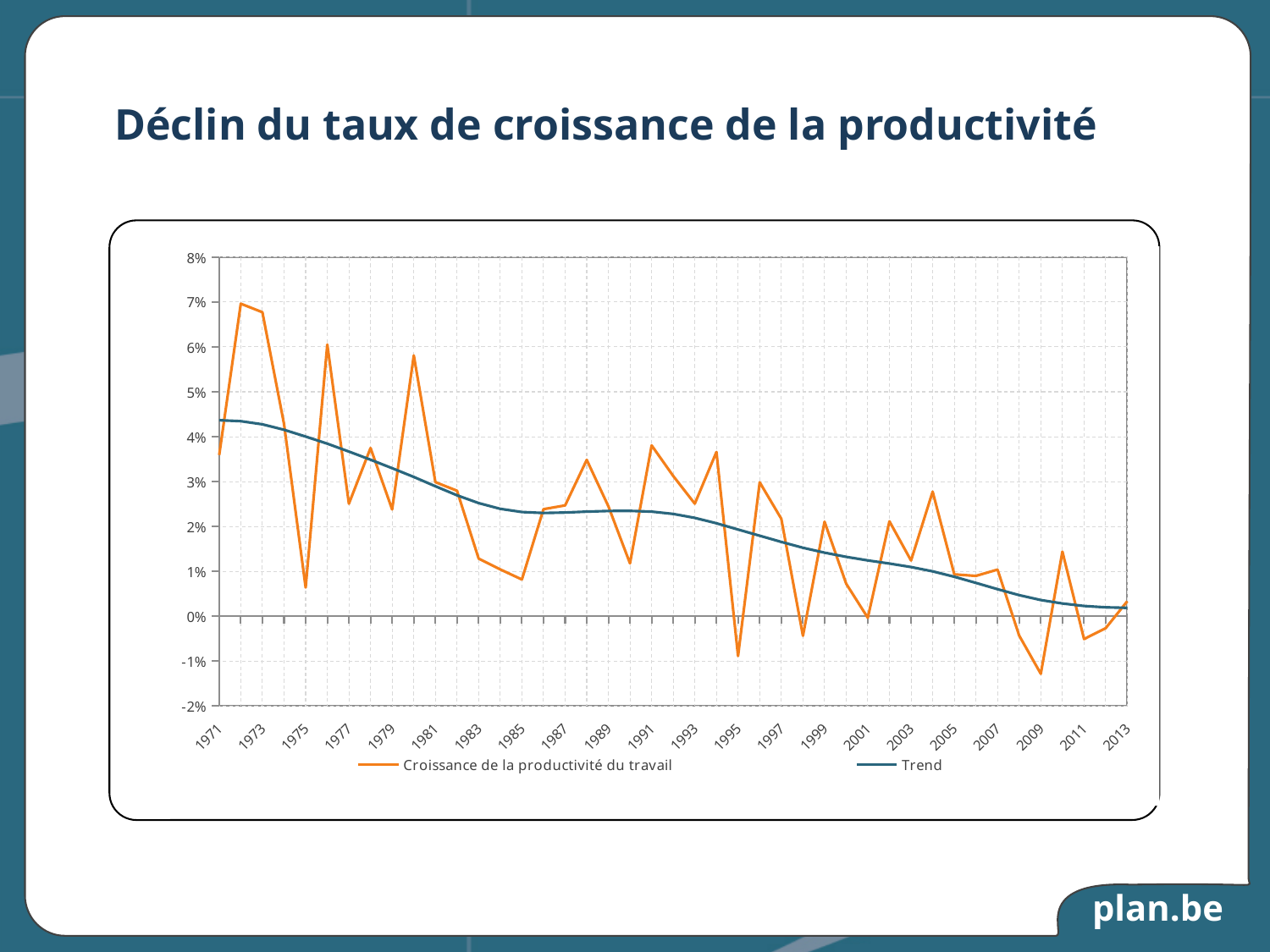
Is the value of Croissance de la productivité du travail in 1981 greater or less than 5%? less Is the value of Croissance de la productivité du travail in 1995 greater or less than 0%? less Does the Trend line rise or fall from 1971 to 2013? fall In which year does Croissance de la productivité du travail reach its lowest value? 2009 How many series does the legend list? 2 Is the value of Croissance de la productivité du travail in 1972 greater or less than 6%? greater Which is larger: the Trend value in 1971 or the Trend value in 2013? 1971 What is the title of the slide containing the chart? Déclin du taux de croissance de la productivité What kind of chart is shown on the slide? line chart What are the two series named in the legend? Croissance de la productivité du travail; Trend